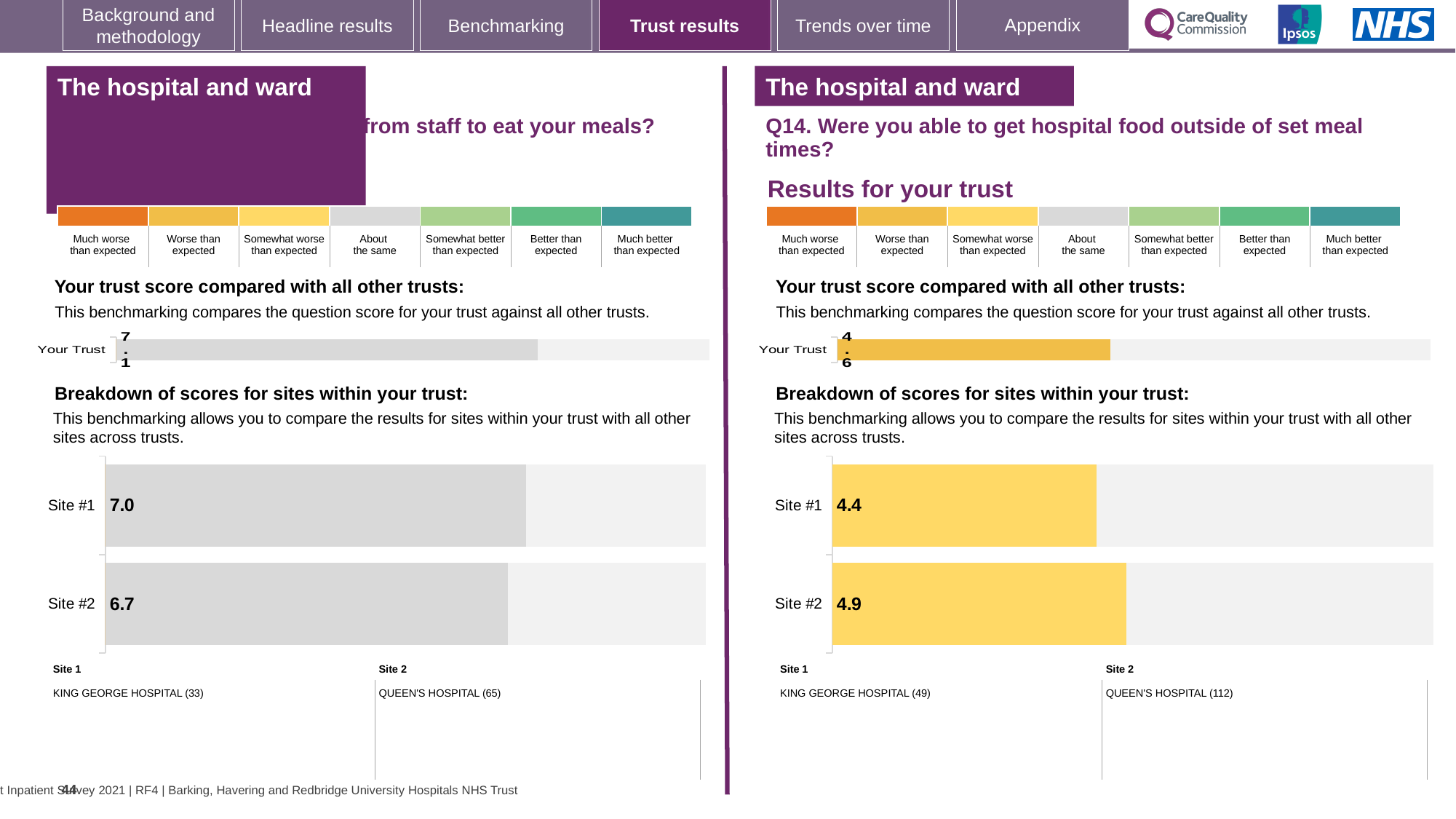
On the Q14 panel's site breakdown chart, which site has the lower score? Site #1 On the Q14 panel's 'Breakdown of scores for sites within your trust' chart, what is the score for Site #2? 4.9 On the left-hand panel's 'Breakdown of scores for sites within your trust' chart, what is the score for Site #1? 7.0 On the left-hand panel's 'Breakdown of scores for sites within your trust' chart, what is the score for Site #2? 6.7 On the left-hand panel's 'Your trust score compared with all other trusts' chart, what is the value shown for Your Trust? 7.1 On the Q14 panel's site breakdown chart, what is the difference between the Site #2 and Site #1 scores? 0.5 What type of chart is used for the site breakdown on the Q14 panel? Bar chart On the Q14 panel's 'Breakdown of scores for sites within your trust' chart, what is the score for Site #1? 4.4 How many sites are shown in the Q14 panel's site breakdown chart? 2 On the Q14 panel's 'Your trust score compared with all other trusts' chart, what is the value shown for Your Trust? 4.6 On the left-hand panel's site breakdown chart, what is the difference between the Site #1 and Site #2 scores? 0.3 On the left-hand panel's site breakdown chart, which site has the higher score? Site #1